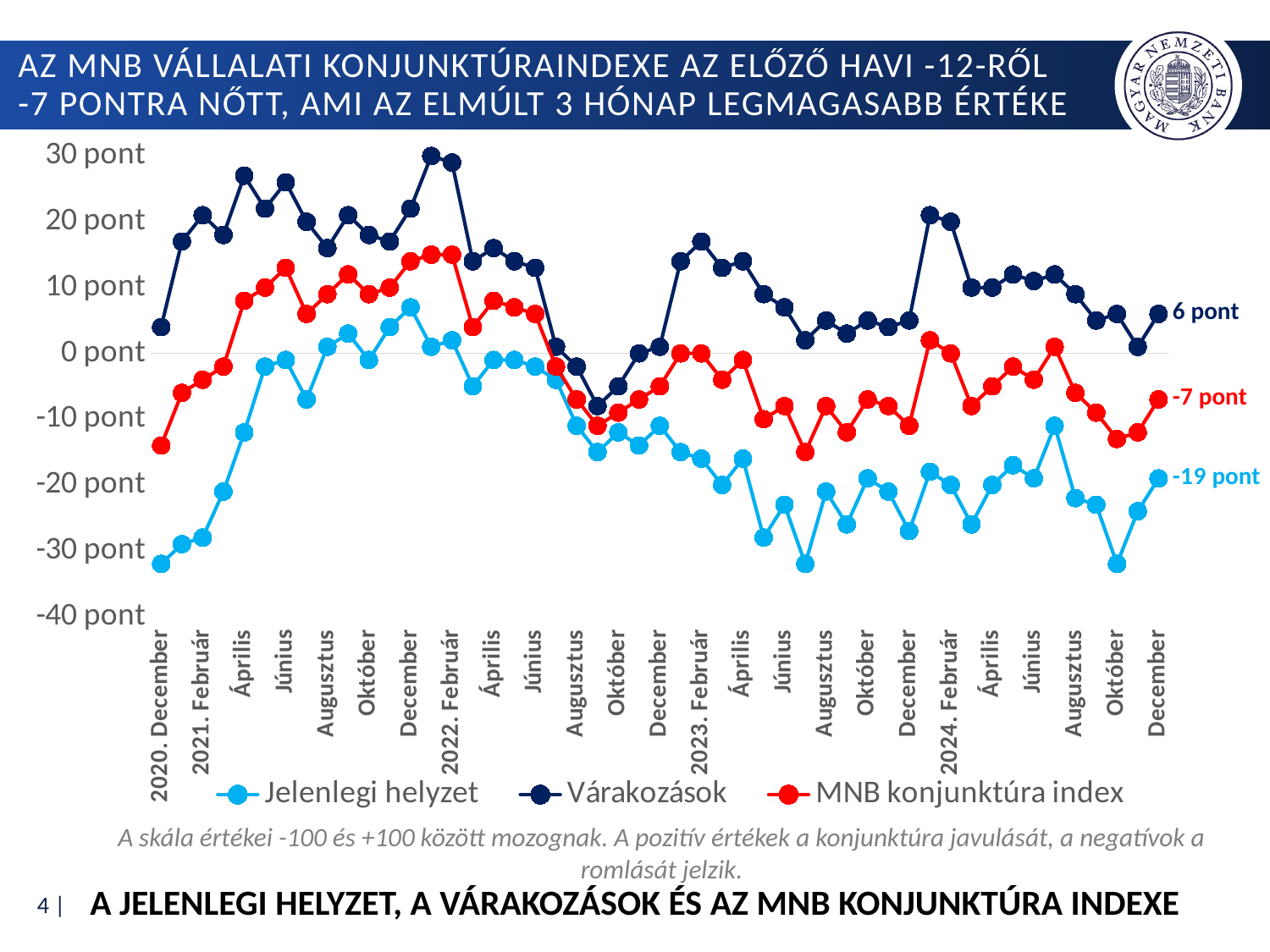
What is the value of the MNB konjunktúra index in 2024 December? -7 pont In 2024 December, what is the difference between the Várakozások value and the Jelenlegi helyzet value? 25 pont What is the value of the Várakozások series in 2024 December? 6 pont What colour is the line for the MNB konjunktúra index series? Red What is the value of the Jelenlegi helyzet series in 2024 December? -19 pont Is the value of Jelenlegi helyzet in 2023 June greater or less than -20 pont? less How many series does the legend list? 3 What kind of chart is shown on the slide? Line chart Is the value of Várakozások in 2021 April greater or less than 20 pont? greater In 2024 December, which is higher: Várakozások or Jelenlegi helyzet? Várakozások Which series has the lowest value in 2024 December? Jelenlegi helyzet In 2024 December, what is the difference between the Várakozások value and the MNB konjunktúra index value? 13 pont